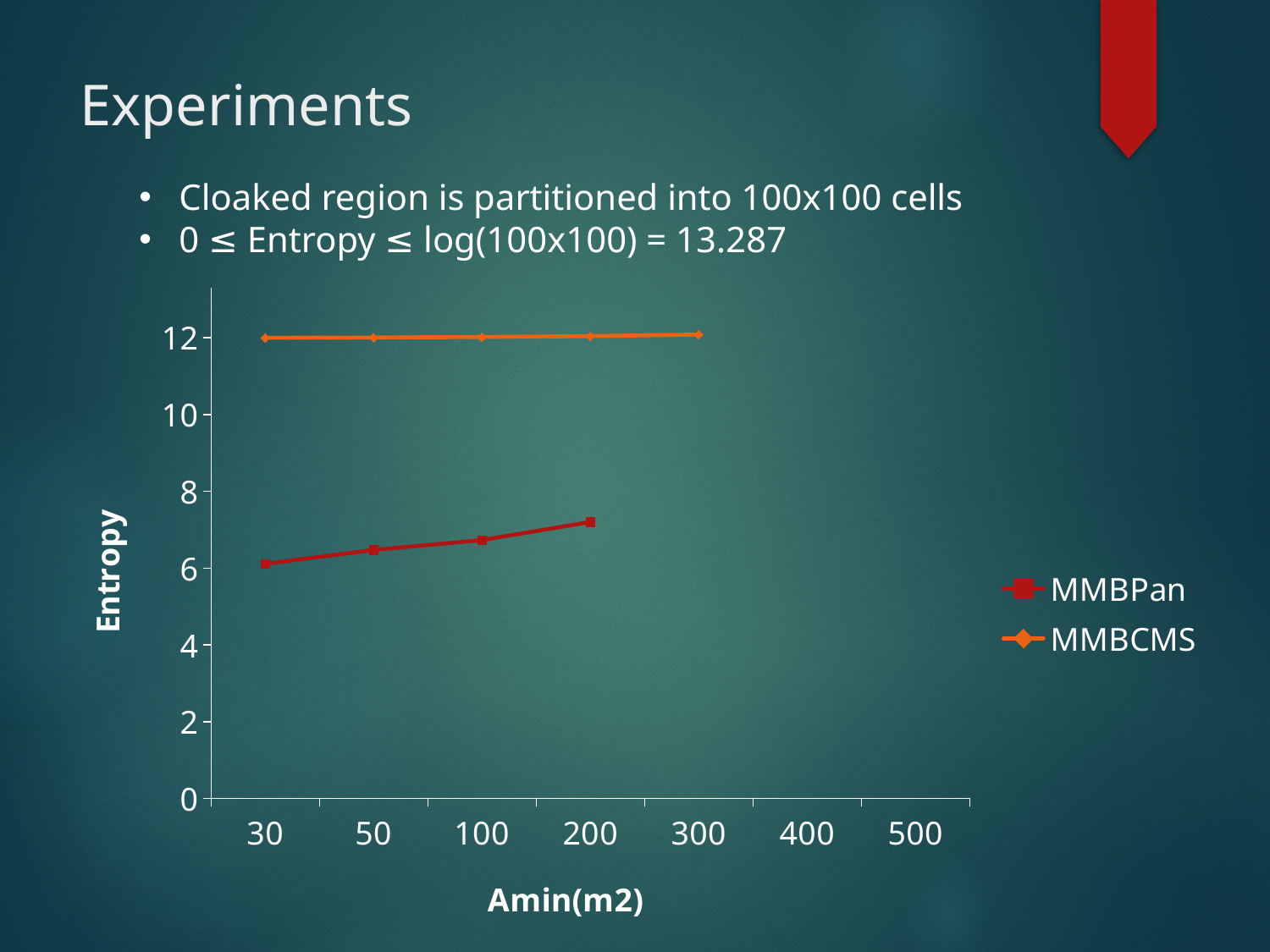
Is the Entropy value for MMBPan at Amin = 200 greater or less than 6? greater Is the Entropy value for MMBCMS at Amin = 30 greater or less than 10? greater How many tick labels are shown on the x axis (Amin(m2))? 7 What kind of chart is shown on the slide? line chart Is the Entropy value for MMBPan at Amin = 30 greater or less than 8? less How many series does the legend list? 2 Which series has the higher Entropy at Amin = 100, MMBPan or MMBCMS? MMBCMS What is the title of the y axis? Entropy Does the Entropy for MMBPan rise or fall as Amin increases from 30 to 200? rise What is the title of the x axis? Amin(m2) How many data points are plotted for the MMBPan series? 4 How many data points are plotted for the MMBCMS series? 5